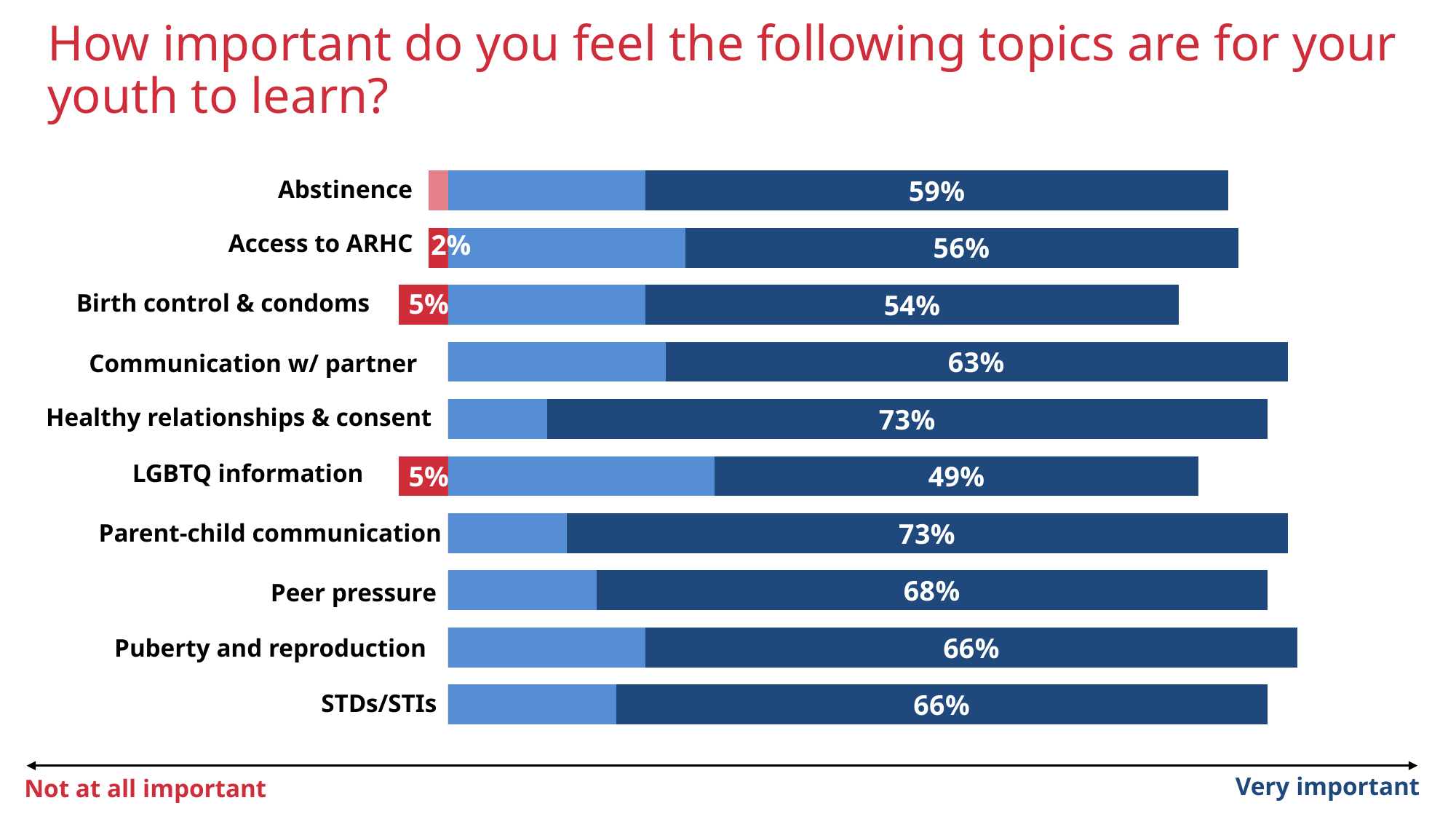
What percentage of respondents rated Healthy relationships & consent as very important (the dark blue segment)? 73% What kind of chart is shown on the slide? Stacked bar chart Which two topics share the highest dark blue 'very important' percentage of 73%? Healthy relationships & consent and Parent-child communication What is the difference in percentage points between the dark blue values for Parent-child communication and LGBTQ information? 24 percentage points Which topic has the lowest dark blue 'very important' percentage? LGBTQ information Which has a larger dark blue 'very important' value, Peer pressure or Abstinence? Peer pressure What value is printed on the red 'not at all important' segment for Access to ARHC? 2% How many topics are listed in the chart? 10 What value is printed on the red segment for Birth control & condoms? 5% What label appears at the right end of the axis arrow below the chart? Very important What is the dark blue 'very important' value shown for LGBTQ information? 49% What is the dark blue value shown for Peer pressure? 68%